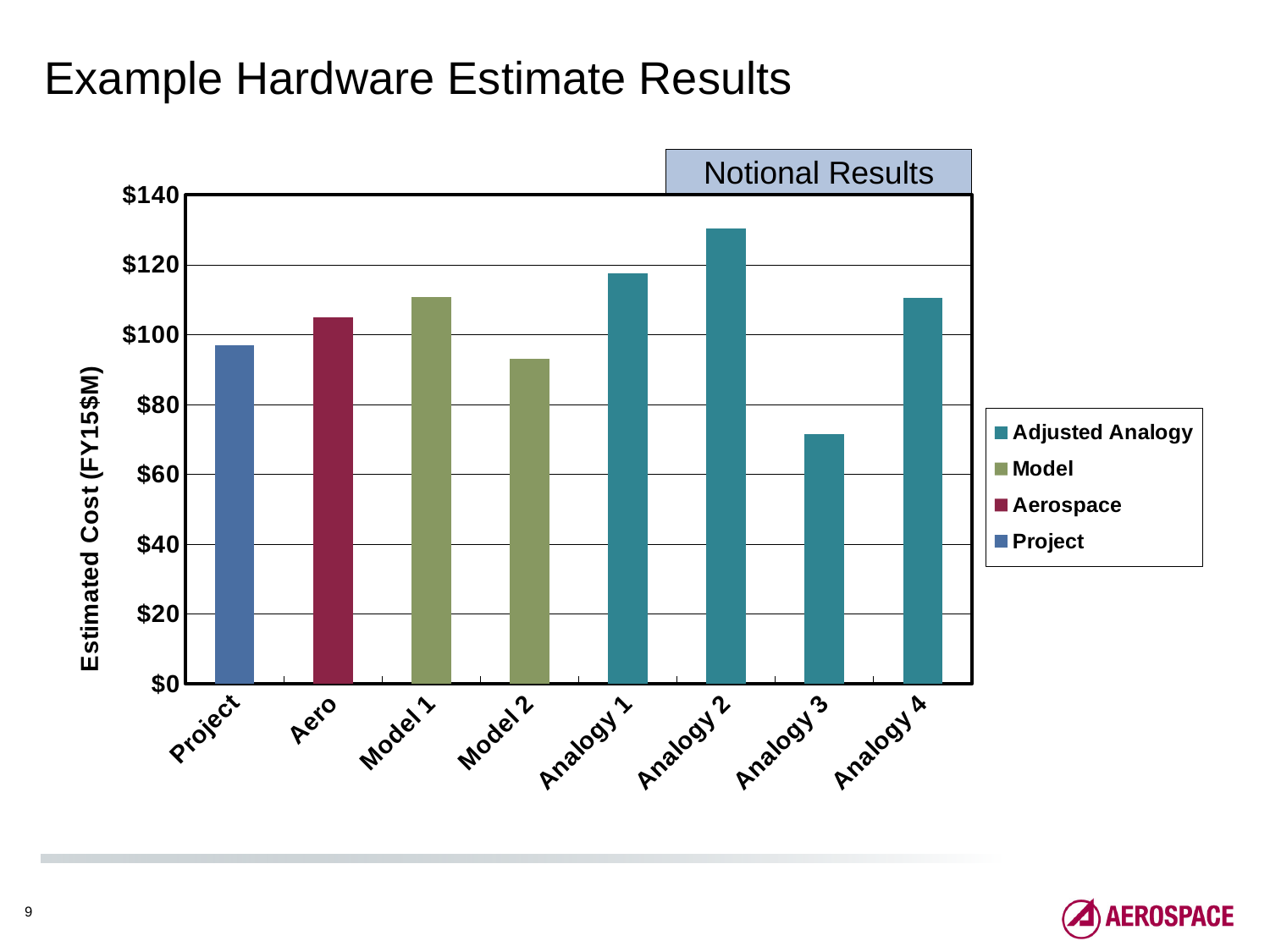
Is the value for Analogy 2 greater or less than $120? greater Is the value for Model 2 greater or less than $100? less What kind of chart is shown on the slide? Bar chart How many series does the legend list? 4 How many categories are shown on the x axis? 8 Which category has the highest bar? Analogy 2 Which category has the lowest bar? Analogy 3 Is the value for Project greater or less than $100? less Which is larger, the value for Project or the value for Aero? Aero Which is larger, the value for Analogy 1 or the value for Model 2? Analogy 1